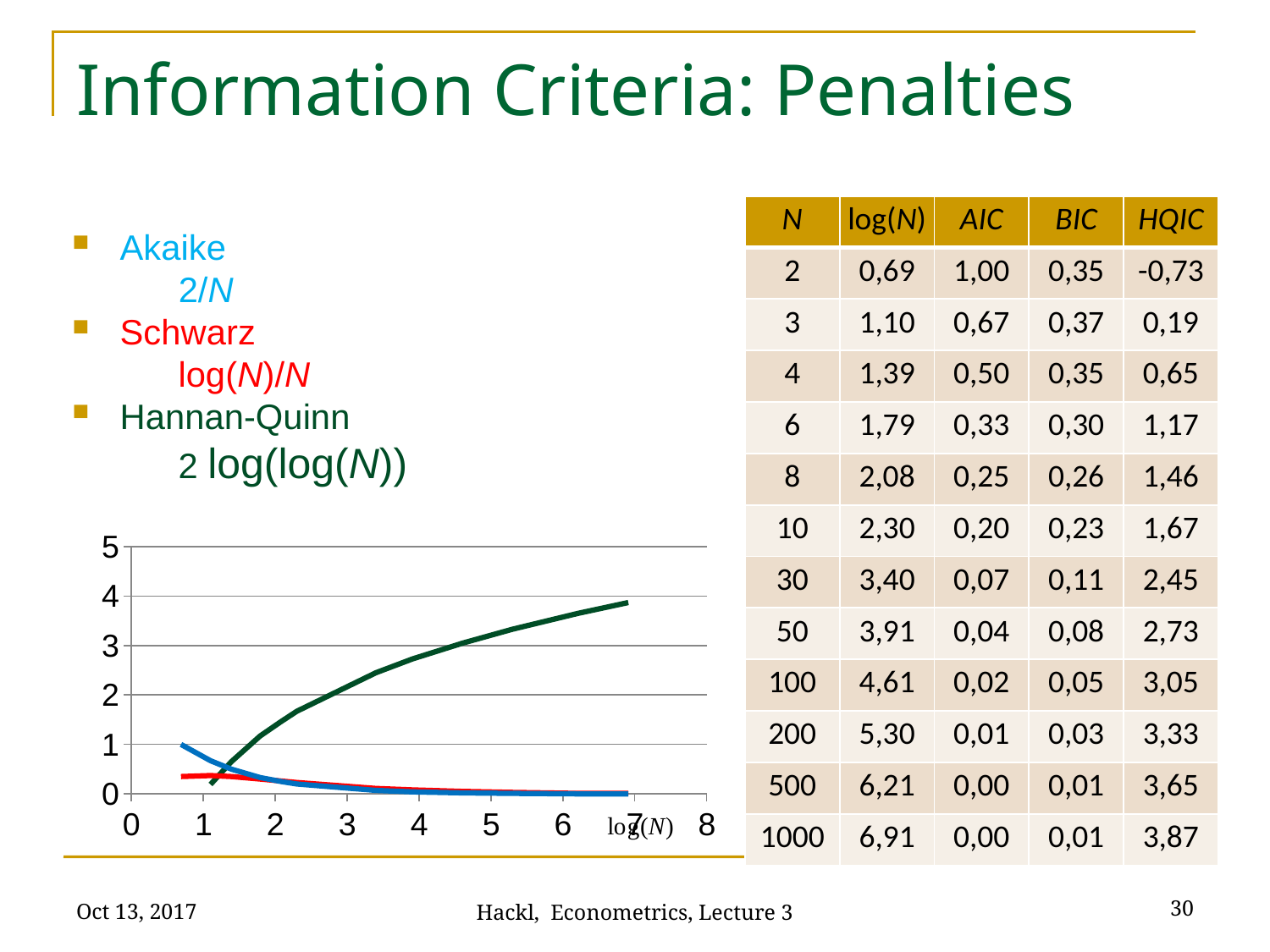
What is the label on the x axis of the chart? log(N) How many lines are plotted in the chart? 3 At log(N) = 1, which line has the larger value, the blue line or the red line? blue line Is the value of the green line at log(N) = 7 greater or less than 3? greater Does the blue line (Akaike penalty) rise or fall as log(N) increases? fall What kind of chart is shown on the slide? line chart Is the value of the blue line at log(N) = 4 greater or less than 1? less Does the red line (Schwarz penalty) rise or fall as log(N) increases? fall Does the green line (Hannan-Quinn penalty) rise or fall as log(N) increases? rise What is the highest value shown on the y axis of the chart? 5 Is the value of the green line at log(N) = 1 greater or less than 1? less At log(N) = 6, which line has the larger value, the green line or the red line? green line